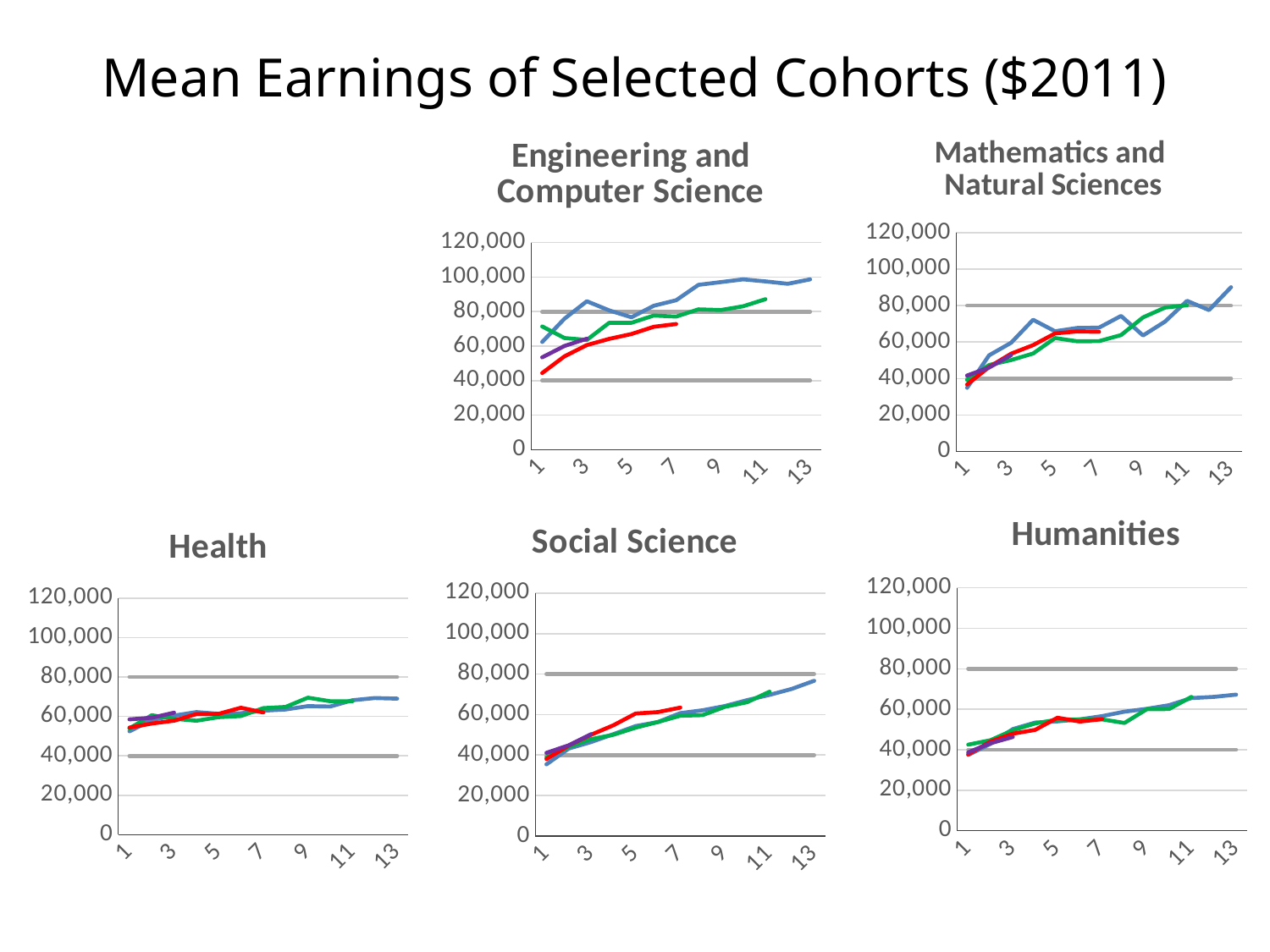
In the Engineering and Computer Science chart, is the value of the blue line at 13 greater or less than 80,000? greater What kind of chart is the Health chart? line chart In the Engineering and Computer Science chart, at 9 on the x axis, which line is higher, the blue line or the green line? the blue line How many charts are shown on the slide? 5 In the Engineering and Computer Science chart, is the value of the red line at 1 greater or less than 60,000? less In the Humanities chart, is the value of the green line at 1 greater or less than 60,000? less What is the highest value shown on the vertical axis of the Social Science chart? 120,000 In the Humanities chart, does the blue line generally rise or fall along the x axis? rise In the Social Science chart, does the blue line generally rise or fall along the x axis? rise